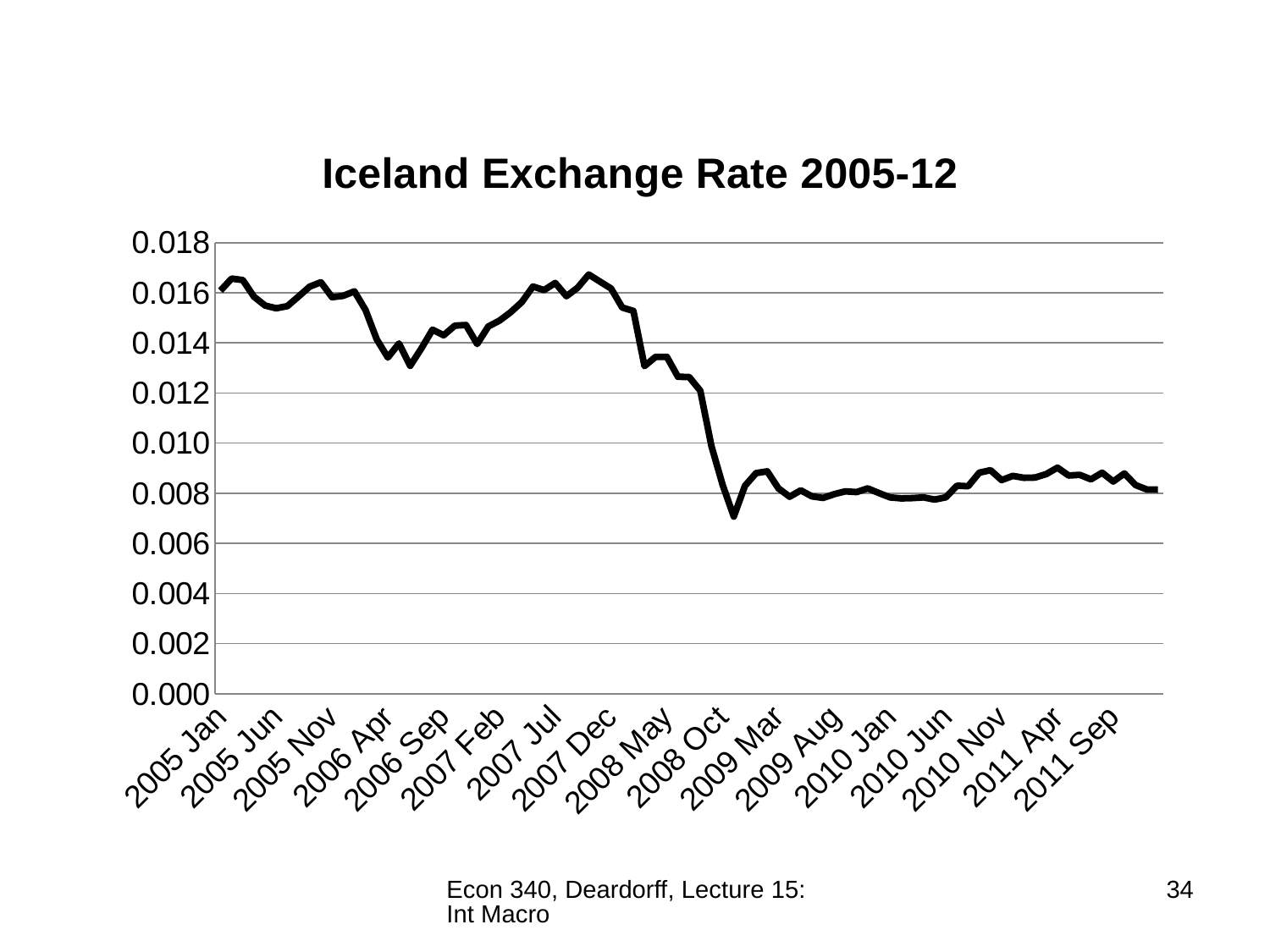
Is the value for 2006 Apr greater or less than 0.012? greater What is the title of the chart? Iceland Exchange Rate 2005-12 Overall, does the exchange rate rise or fall from 2005 Jan to 2011 Sep? fall What kind of chart is shown on the slide? line chart Is the value for 2007 Dec greater or less than 0.014? greater What is the highest value shown on the y axis? 0.018 Is the value for 2010 Jan greater or less than 0.010? less Which is larger, the value for 2005 Jan or the value for 2011 Sep? 2005 Jan How many date labels are shown along the x axis? 17